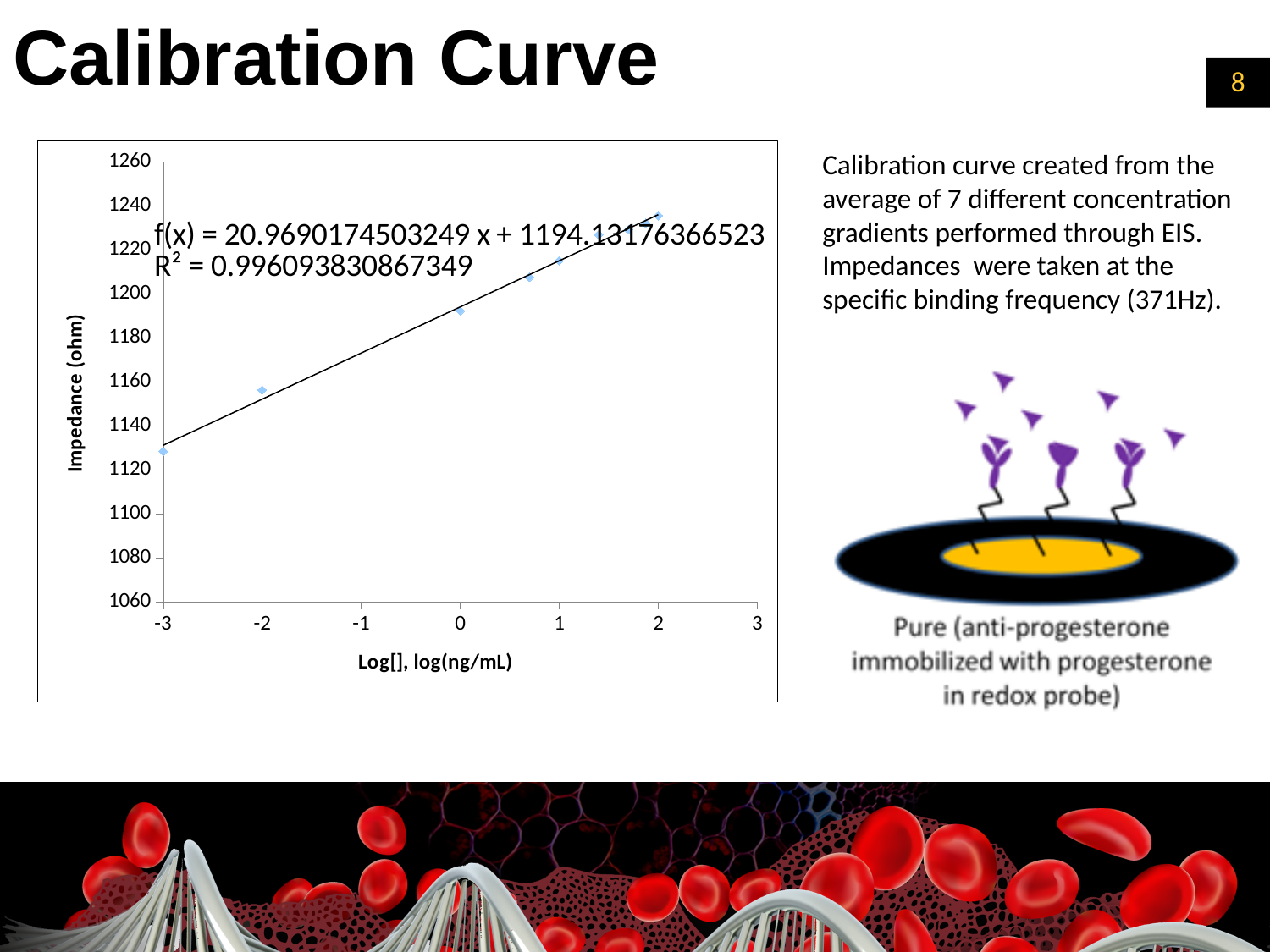
What R² value is shown for the fitted line on the chart? 0.996093830867349 Is the impedance at Log[] = -2 greater or less than 1140? greater At which Log[] value is the plotted impedance highest? 2 Do the impedance values rise or fall as Log[] increases along the x axis? rise Is the impedance at Log[] = 0 greater or less than 1180? greater At which Log[] value is the plotted impedance lowest? -3 Which has the larger impedance: the point at Log[] = -2 or the point at Log[] = 1? Log[] = 1 What is the title of the y axis on the chart? Impedance (ohm) What kind of chart is shown on the slide? scatter chart Is the impedance at Log[] = 2 greater or less than 1220? greater How many data points are plotted on the chart? 9